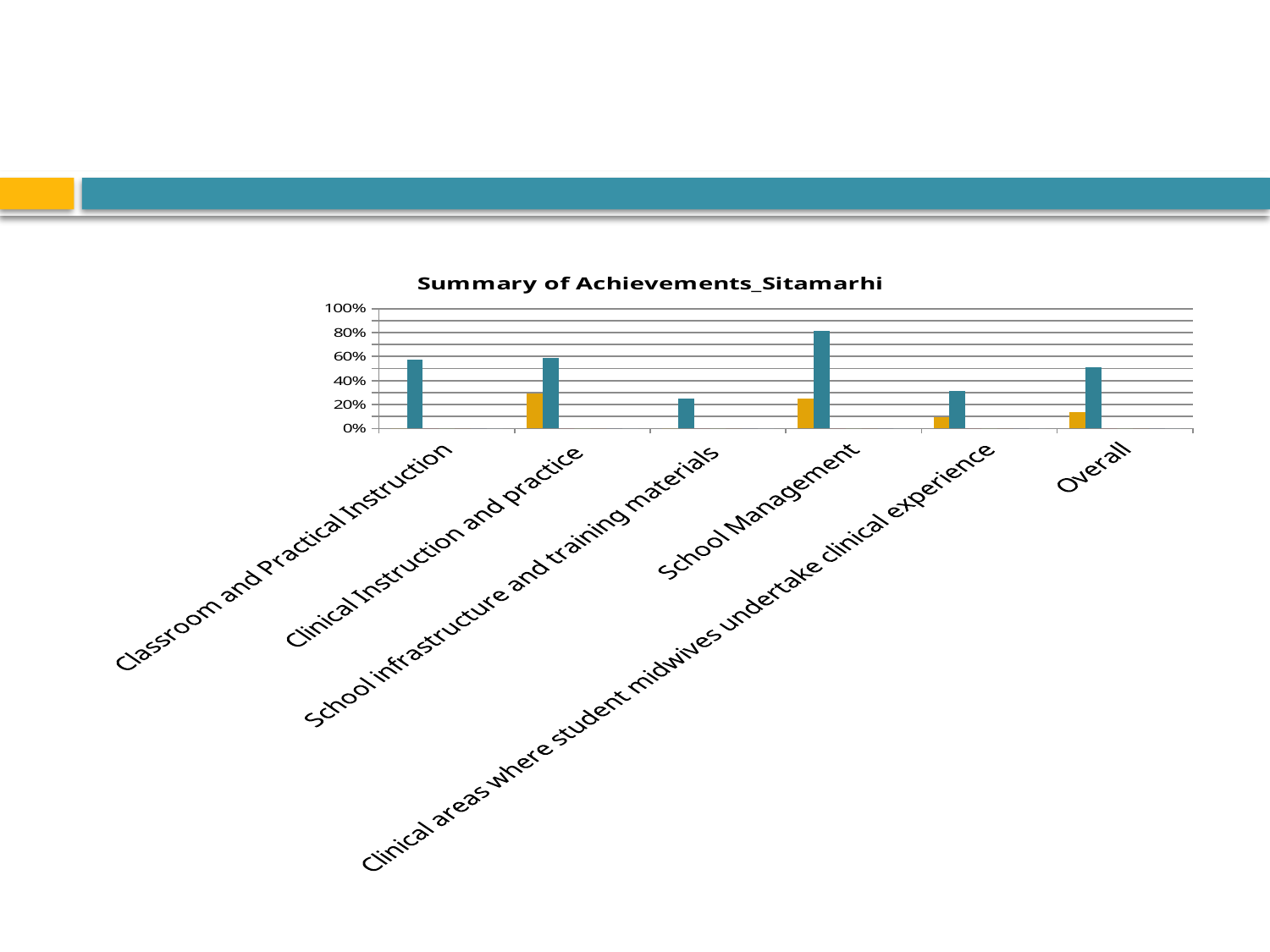
Is the teal bar for School Management greater or less than 60%? greater Which category has a smaller teal bar: School infrastructure and training materials or Clinical Instruction and practice? School infrastructure and training materials What kind of chart is shown on the slide? bar chart What is the title of the chart? Summary of Achievements_Sitamarhi Which category has the tallest teal bar? School Management Is the orange bar for Clinical areas where student midwives undertake clinical experience greater or less than 20%? less Is the teal bar for School infrastructure and training materials greater or less than 40%? less What is the highest value shown on the y axis of the chart? 100% Which is larger for School Management: the orange bar or the teal bar? the teal bar How many categories are shown on the x axis of the chart? 6 Which category has a larger teal bar: School Management or Overall? School Management